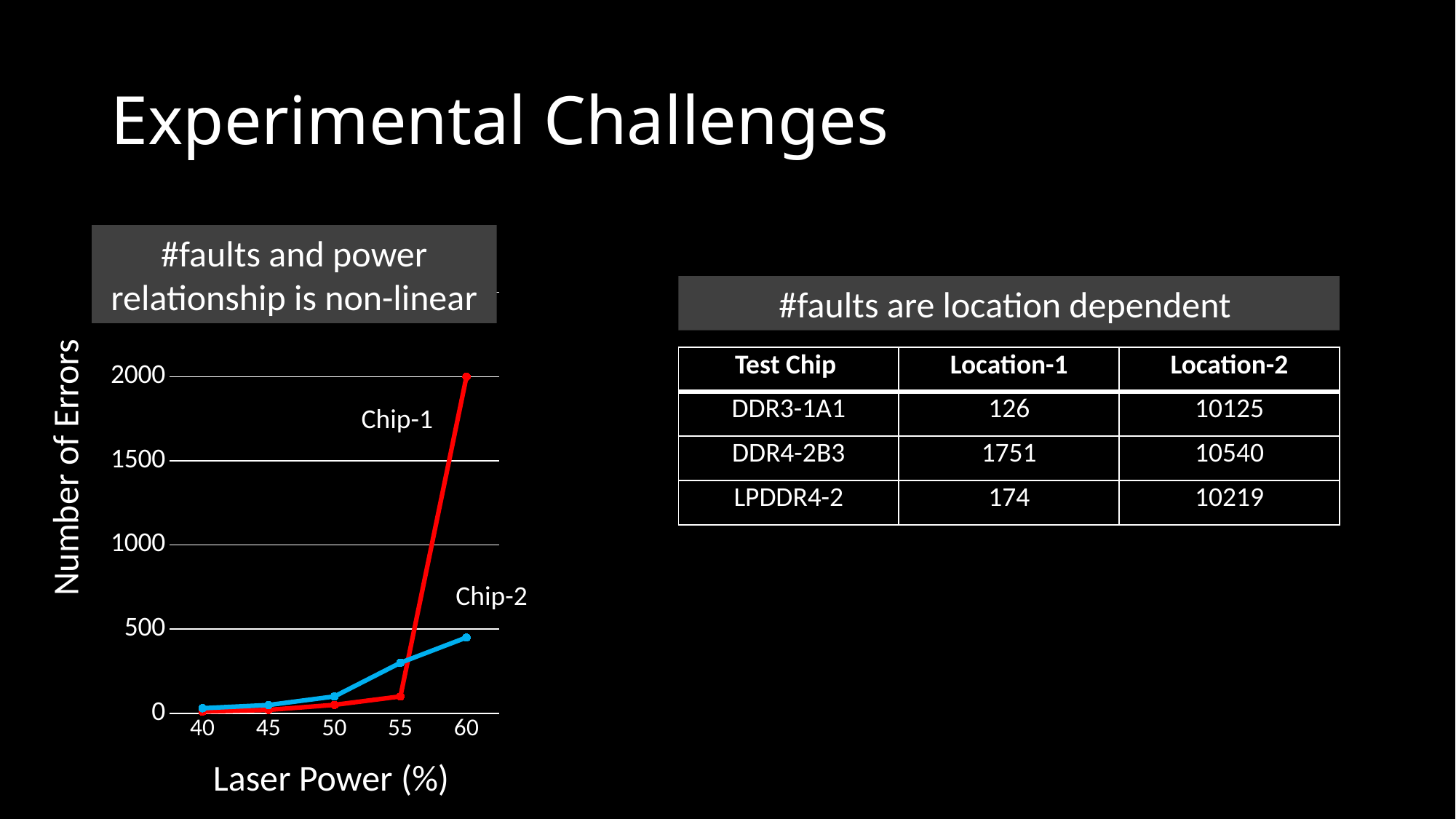
How many laser power values are plotted along the x axis of the line chart? 5 How many series are plotted in the line chart? 2 In the line chart, is the number of errors for Chip-1 at 60% laser power greater or less than 1500? greater In the line chart, which chip has more errors at 60% laser power, Chip-1 or Chip-2? Chip-1 In the line chart, does the number of errors for Chip-1 rise or fall as laser power increases? rise In the line chart, is the number of errors for Chip-2 at 60% laser power greater or less than 500? less In the line chart, which chip has more errors at 55% laser power, Chip-1 or Chip-2? Chip-2 What is the title of the x axis of the line chart? Laser Power (%) What is the title of the y axis of the line chart? Number of Errors In the line chart, is the number of errors for Chip-1 at 55% laser power greater or less than 500? less What kind of chart is shown on the left of the slide? line chart